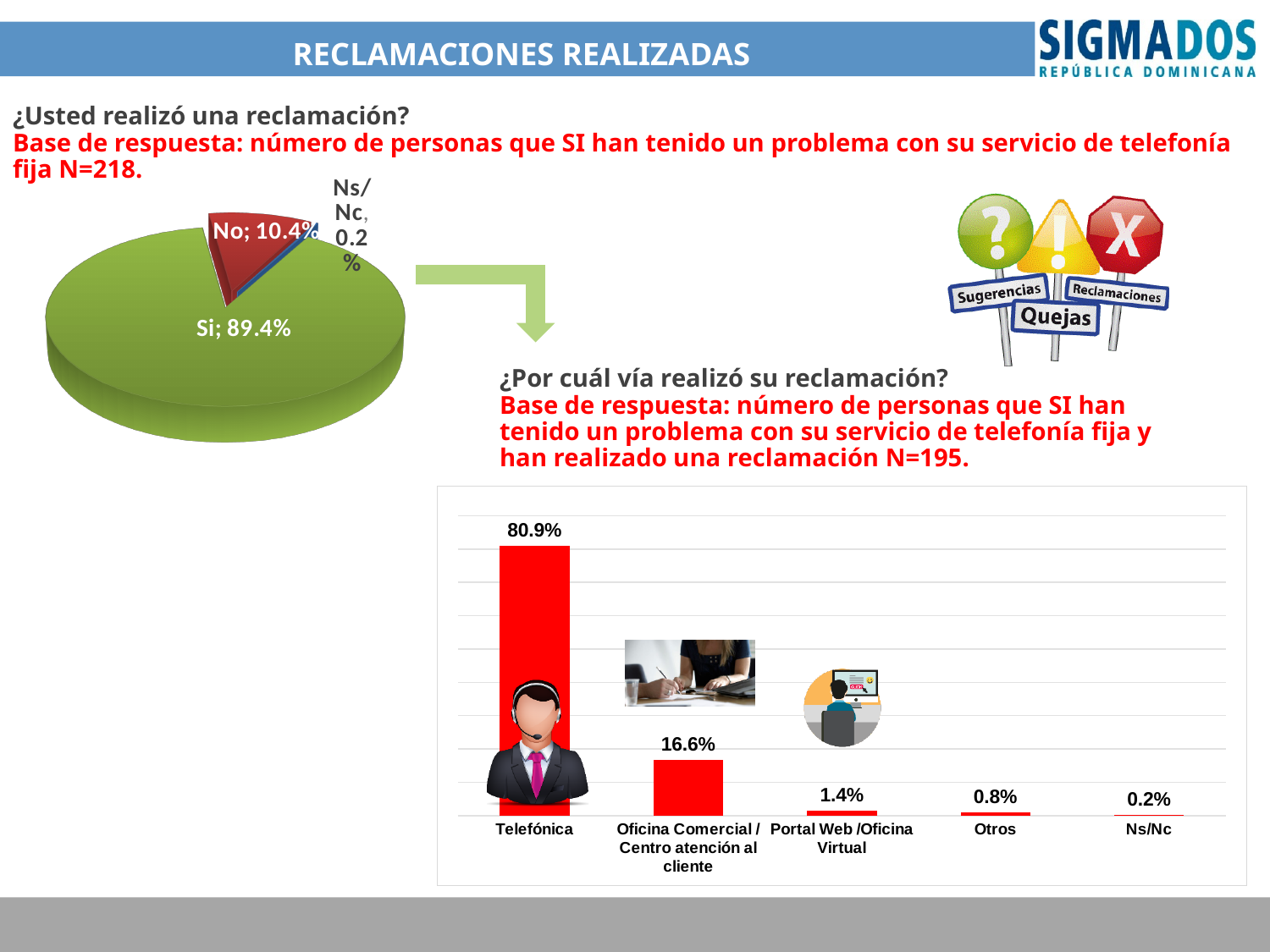
In the bar chart at the bottom right, which category has the lowest value? Ns/Nc In the bar chart at the bottom right, how many categories are shown on the x axis? 5 In the bar chart at the bottom right, what is the difference between the values for Telefónica and Otros? 80.1% In the bar chart at the bottom right, which category has the highest value? Telefónica In the pie chart on the left, what share of respondents answered "No"? 10.4% In the bar chart at the bottom right, what is the value for Telefónica? 80.9% In the pie chart on the left, what share of respondents answered "Si"? 89.4% In the pie chart on the left, what is the difference between the Si and No shares? 79.0% In the pie chart on the left, how many slices are there? 3 In the bar chart at the bottom right, what is the value for Portal Web /Oficina Virtual? 1.4% In the bar chart at the bottom right, what is the value for Oficina Comercial / Centro atención al cliente? 16.6% In the pie chart on the left, what is the value for Ns/Nc? 0.2%